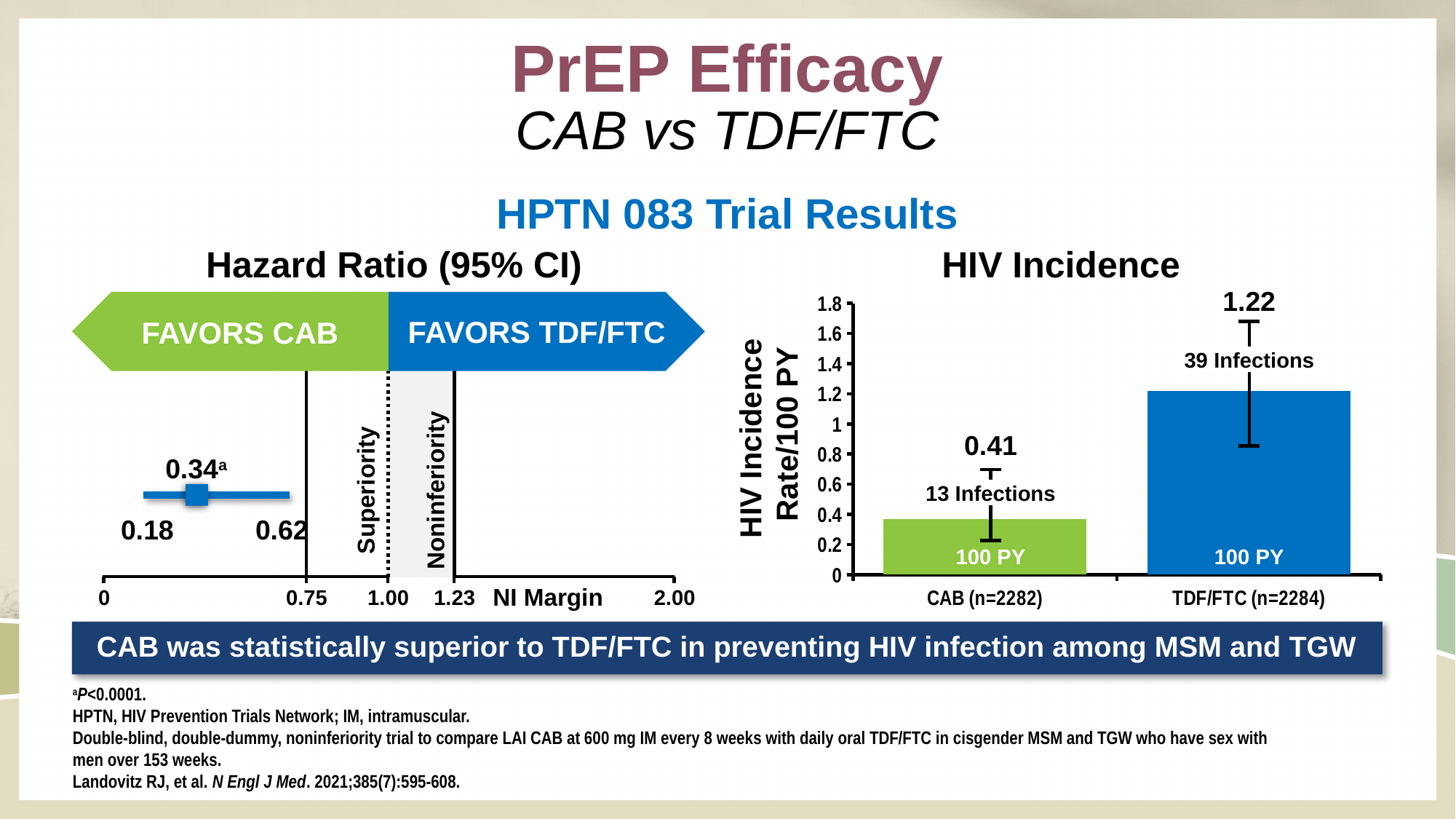
In the Hazard Ratio (95% CI) chart, what is the hazard ratio point estimate for CAB vs TDF/FTC? 0.34 In the HIV Incidence chart, how many more infections occurred in the TDF/FTC arm than in the CAB arm? 26 What kind of chart is the HIV Incidence chart? Bar chart In the HIV Incidence chart, what is the HIV incidence rate per 100 PY for TDF/FTC (n=2284)? 1.22 In the HIV Incidence chart, what is the difference between the TDF/FTC and CAB incidence rates per 100 PY? 0.81 In the HIV Incidence chart, how many infections are reported for the TDF/FTC arm? 39 Infections In the Hazard Ratio (95% CI) chart, what are the lower and upper bounds of the 95% confidence interval? 0.18 and 0.62 In the HIV Incidence chart, which arm has the higher HIV incidence rate? TDF/FTC (n=2284) In the HIV Incidence chart, how many treatment arms are plotted on the x axis? 2 In the HIV Incidence chart, how many infections are reported for the CAB arm? 13 Infections In the Hazard Ratio (95% CI) chart, what value is marked as the NI Margin on the x axis? 1.23 In the HIV Incidence chart, what is the HIV incidence rate per 100 PY for CAB (n=2282)? 0.41